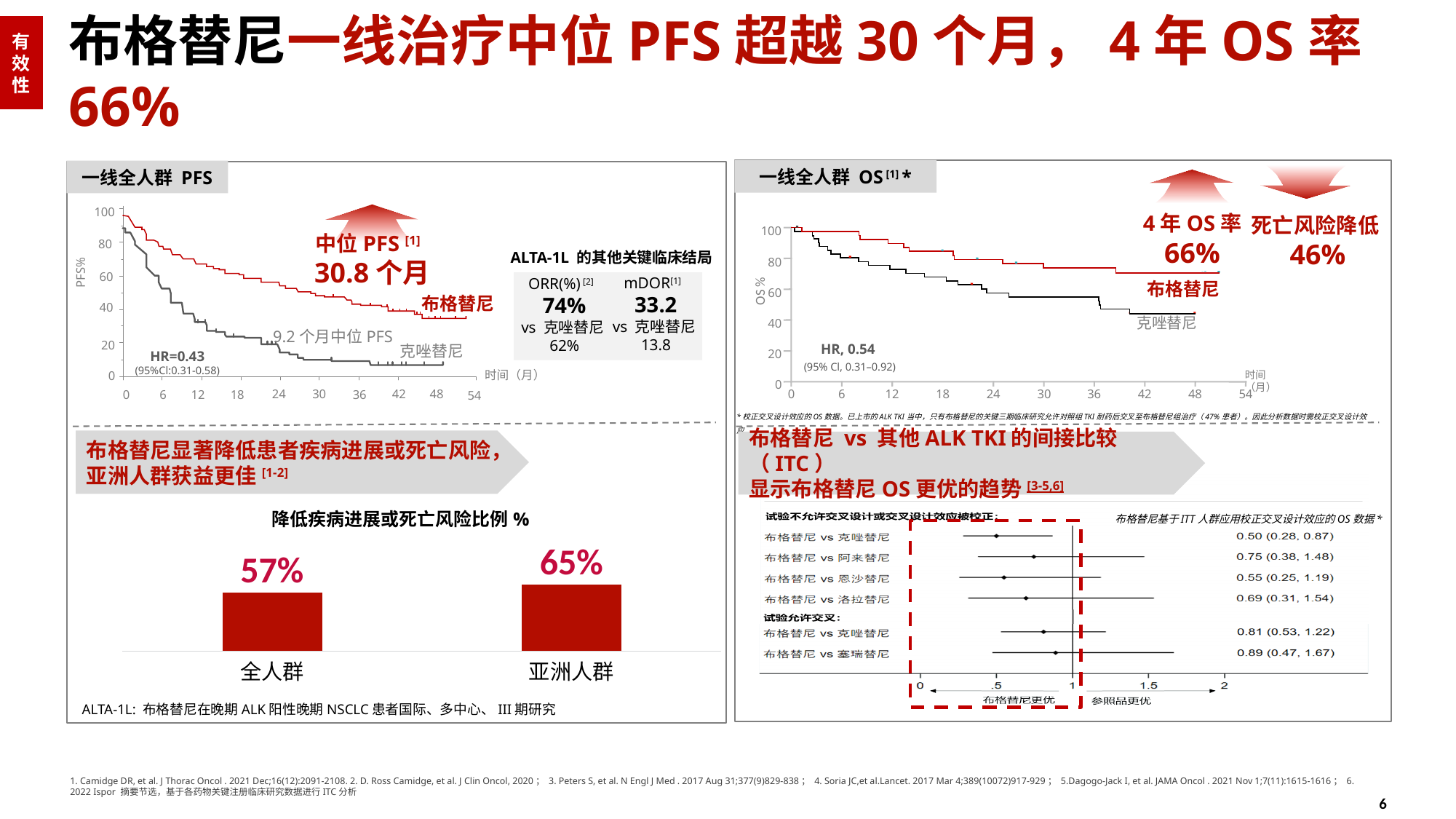
In the bar chart titled 降低疾病进展或死亡风险比例 %, how many categories are shown? 2 In the 一线全人群 PFS chart, what is the median PFS for 布格替尼? 30.8 个月 In the bar chart titled 降低疾病进展或死亡风险比例 %, what is the value for 亚洲人群? 65% In the forest plot on the lower right, how many comparisons are listed? 6 In the bar chart titled 降低疾病进展或死亡风险比例 %, which category has the higher value? 亚洲人群 In the 一线全人群 OS chart, what is the hazard ratio (HR) shown? HR, 0.54 In the forest plot on the lower right, what is the value shown for 布格替尼 vs 阿来替尼? 0.75 (0.38, 1.48) What kind of chart is the 降低疾病进展或死亡风险比例 % chart on the lower left? bar chart In the 一线全人群 PFS chart, what is the median PFS for 克唑替尼? 9.2 个月 In the 一线全人群 PFS chart, what is the hazard ratio (HR) shown? HR=0.43 In the bar chart titled 降低疾病进展或死亡风险比例 %, what is the difference between the 亚洲人群 and 全人群 values? 8% In the bar chart titled 降低疾病进展或死亡风险比例 %, what is the value for 全人群? 57%